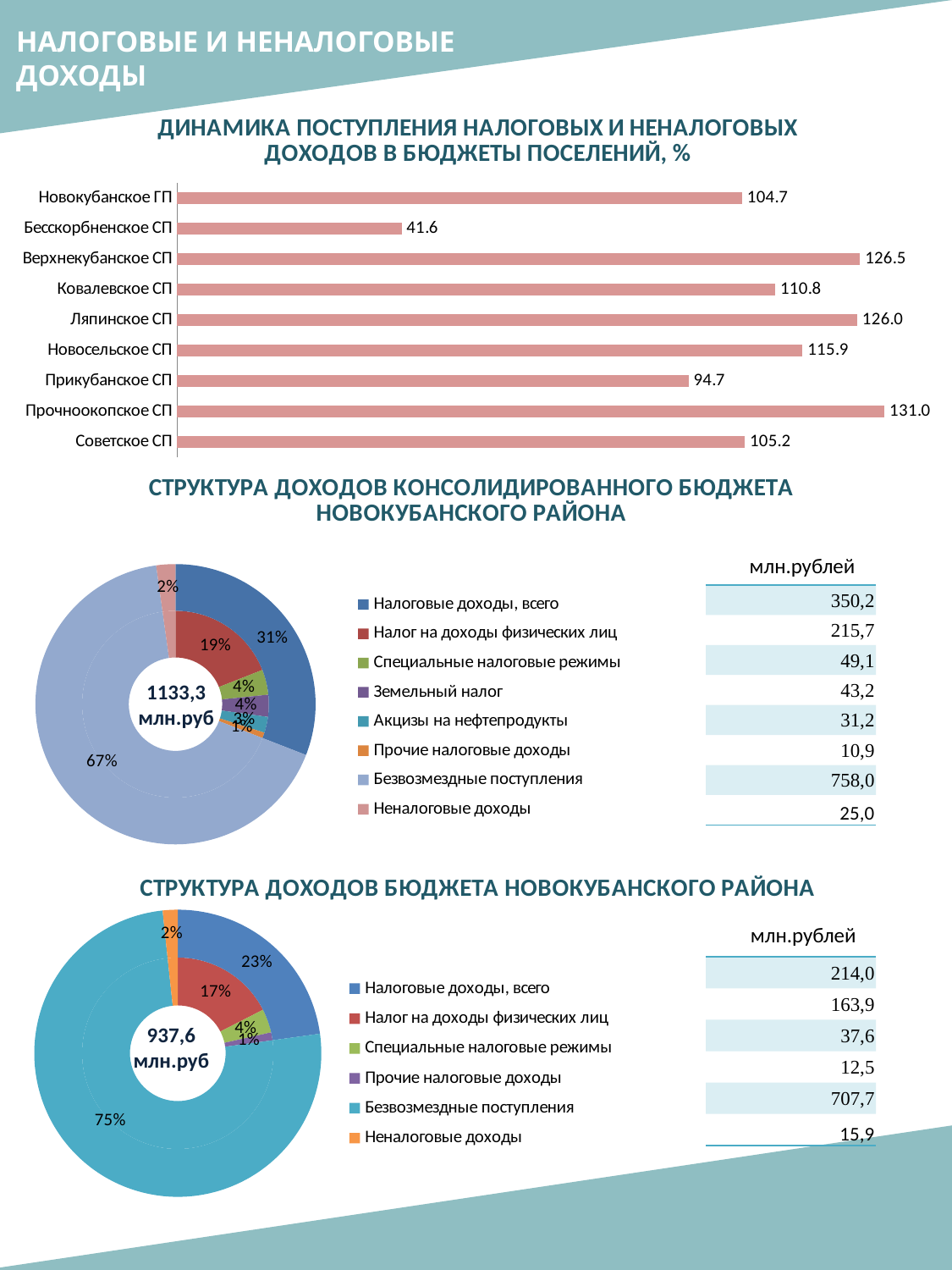
In the chart 'Структура доходов консолидированного бюджета Новокубанского района', what share do Безвозмездные поступления make up? 67% In the bar chart 'Динамика поступления налоговых и неналоговых доходов в бюджеты поселений, %', which settlement has the lowest value? Бесскорбненское СП In the chart 'Структура доходов бюджета Новокубанского района', what share do Налоговые доходы, всего make up? 23% In the bar chart 'Динамика поступления налоговых и неналоговых доходов в бюджеты поселений, %', what is the difference between the values for Верхнекубанское СП and Прикубанское СП? 31.8 What type of chart is the top chart 'Динамика поступления налоговых и неналоговых доходов в бюджеты поселений, %'? Bar chart In the chart 'Структура доходов бюджета Новокубанского района', what total amount is shown in the centre of the doughnut? 937,6 млн.руб How many entries does the legend of the chart 'Структура доходов консолидированного бюджета Новокубанского района' list? 8 In the bar chart 'Динамика поступления налоговых и неналоговых доходов в бюджеты поселений, %', which settlement has the highest value? Прочноокопское СП In the bar chart 'Динамика поступления налоговых и неналоговых доходов в бюджеты поселений, %', which is larger: the value for Новосельское СП or the value for Советское СП? Новосельское СП In the bar chart 'Динамика поступления налоговых и неналоговых доходов в бюджеты поселений, %', what is the value for Ковалевское СП? 110.8 How many settlements are shown in the bar chart 'Динамика поступления налоговых и неналоговых доходов в бюджеты поселений, %'? 9 In the chart 'Структура доходов консолидированного бюджета Новокубанского района', what is the value in млн.рублей for Налог на доходы физических лиц? 215,7